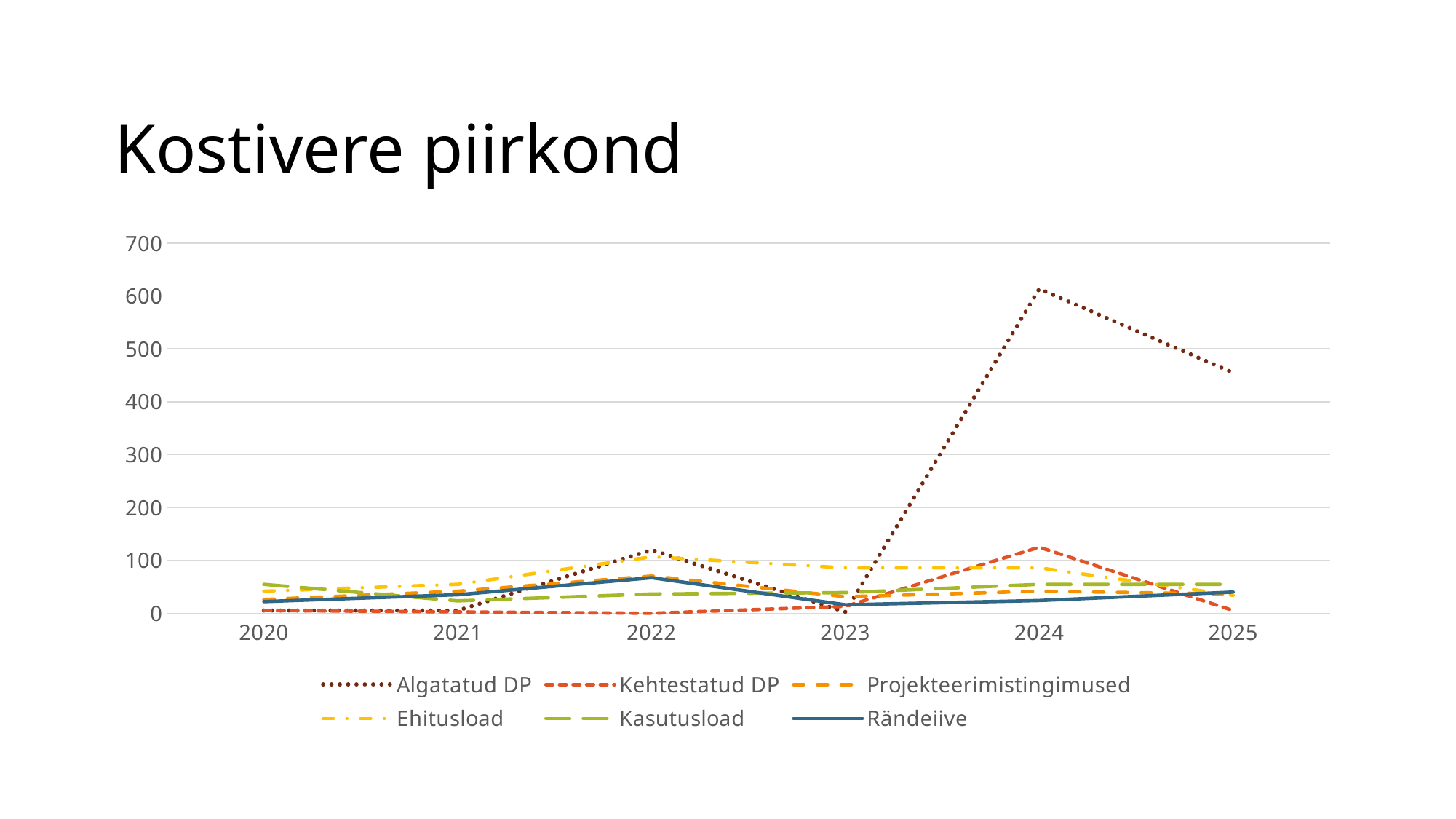
Is the value for Algatatud DP in 2024 greater or less than 500? greater Which is larger in 2024, Algatatud DP or Kehtestatud DP? Algatatud DP In which year does Algatatud DP reach its highest value? 2024 Does the Algatatud DP line rise or fall from 2024 to 2025? fall Which series has the highest value in 2024? Algatatud DP Which series is drawn as a solid line in the legend? Rändeiive How many years are shown on the x axis? 6 How many series does the legend list? 6 Is the value for Algatatud DP in 2025 greater or less than 500? less What kind of chart is shown on the slide? line chart Is the value for Kehtestatud DP in 2024 greater or less than 100? greater What is the title of the chart? Kostivere piirkond